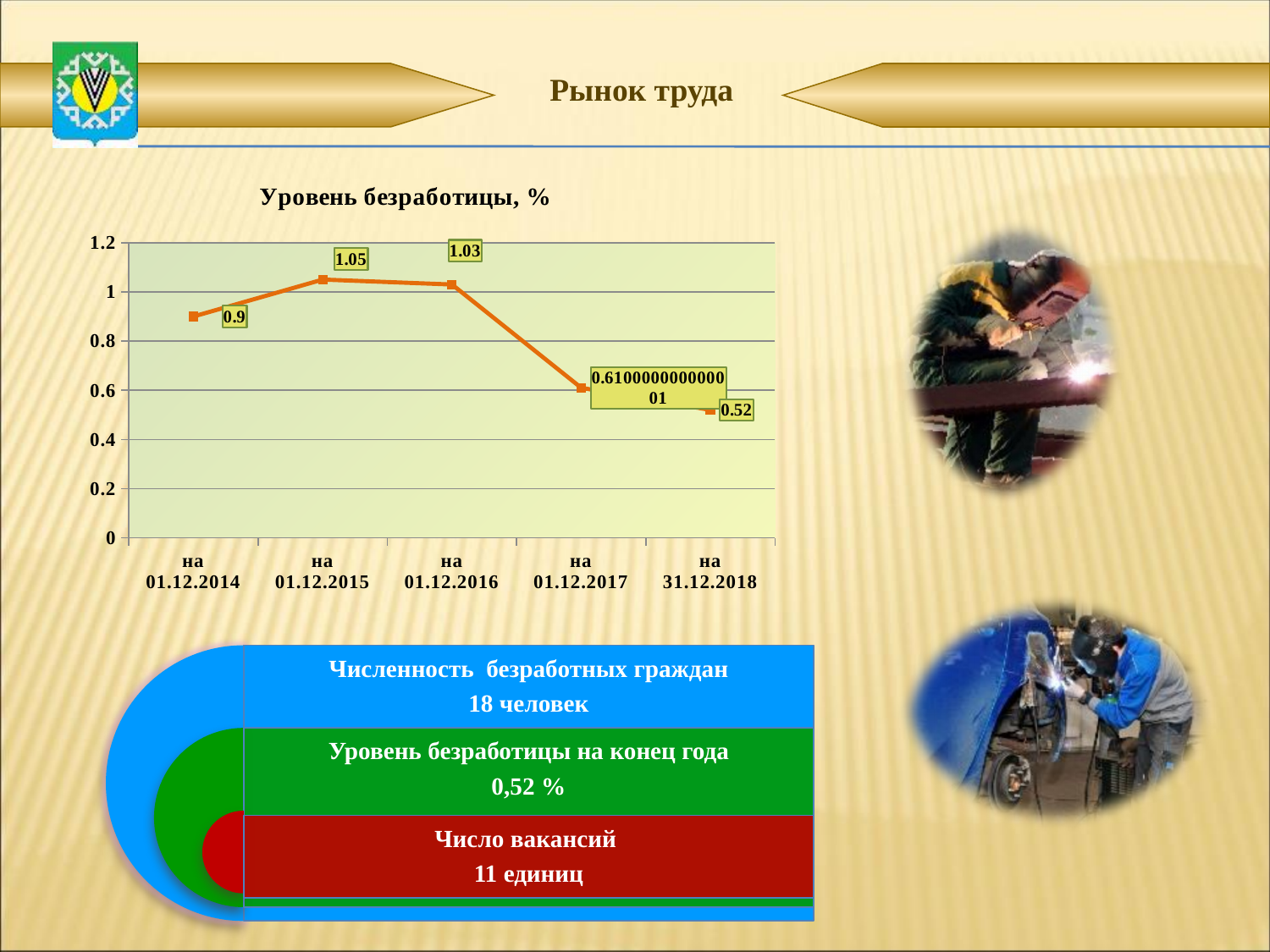
Is the value for на 01.12.2017 greater or less than 0.8? less Which date has the highest unemployment rate? на 01.12.2015 What is the unemployment rate value for на 01.12.2016? 1.03 What is the unemployment rate value for на 31.12.2018? 0.52 What is the title of the chart? Уровень безработицы, % What type of chart is shown on the slide? line chart How many data points are plotted on the chart? 5 Which is larger, the value for на 01.12.2016 or the value for на 31.12.2018? на 01.12.2016 What is the difference between the values for на 01.12.2015 and на 01.12.2014? 0.15 What is the unemployment rate value for на 01.12.2015? 1.05 What is the unemployment rate value for на 01.12.2014? 0.9 Which date has the lowest unemployment rate? на 31.12.2018